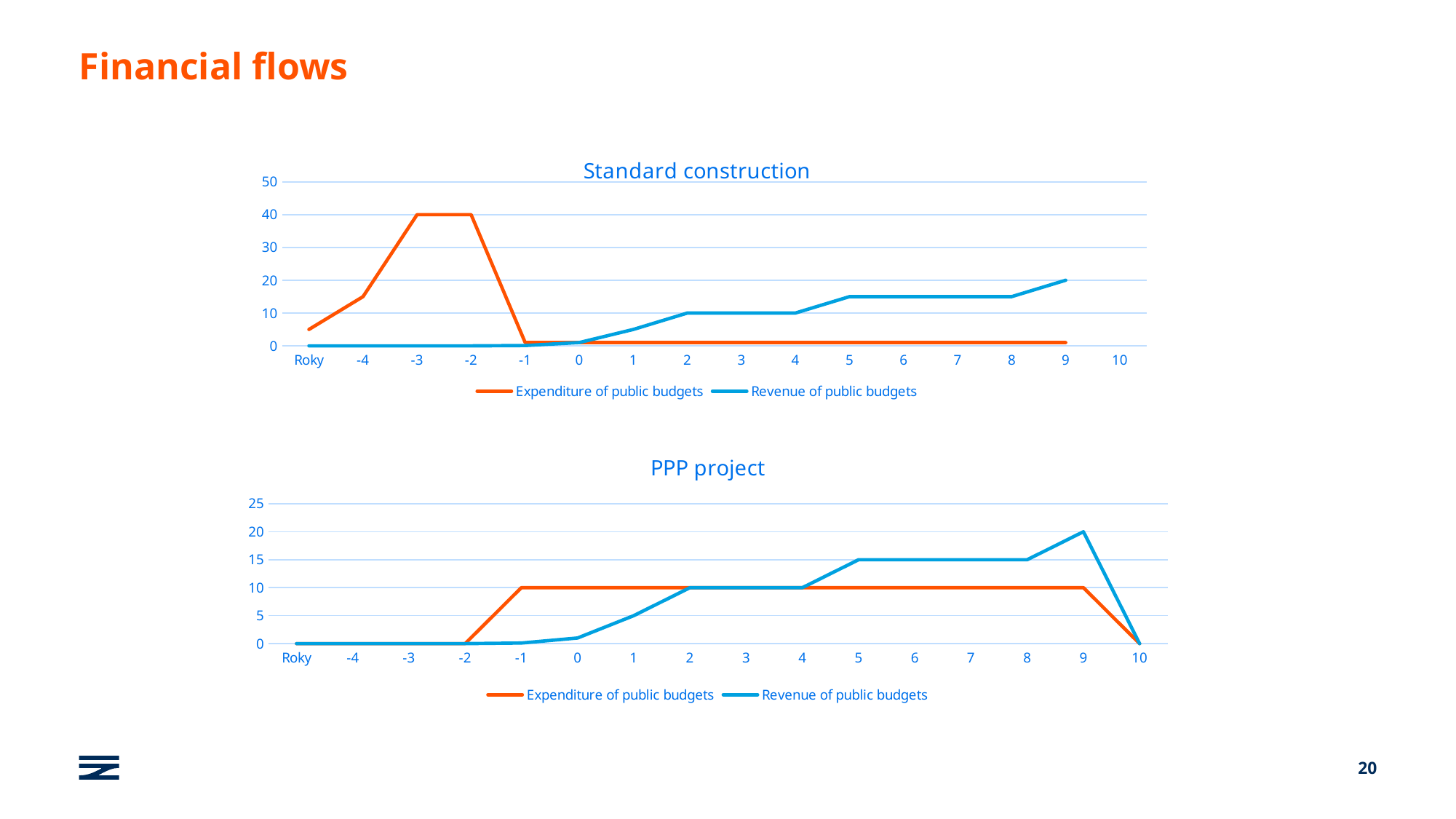
What is the title of the top chart on the slide? Standard construction In the 'PPP project' chart, what is the Revenue of public budgets at year 5? 15 In the 'PPP project' chart, what is the difference between Revenue of public budgets and Expenditure of public budgets at year 9? 10 In the 'PPP project' chart, what is the Expenditure of public budgets at year 2? 10 In the 'PPP project' chart, at year 9, which is larger: Revenue of public budgets or Expenditure of public budgets? Revenue of public budgets In the 'PPP project' chart, which year has the highest Revenue of public budgets? 9 In the 'Standard construction' chart, does the Revenue of public budgets rise or fall from year 0 to year 9? rise What kind of chart is the 'Standard construction' chart? line chart How many series does the legend of the 'PPP project' chart list? 2 In the 'Standard construction' chart, what is the Expenditure of public budgets at year -3? 40 In the 'Standard construction' chart, is the Revenue of public budgets at year 6 greater or less than 10? greater In the 'Standard construction' chart, what is the Revenue of public budgets at year 9? 20